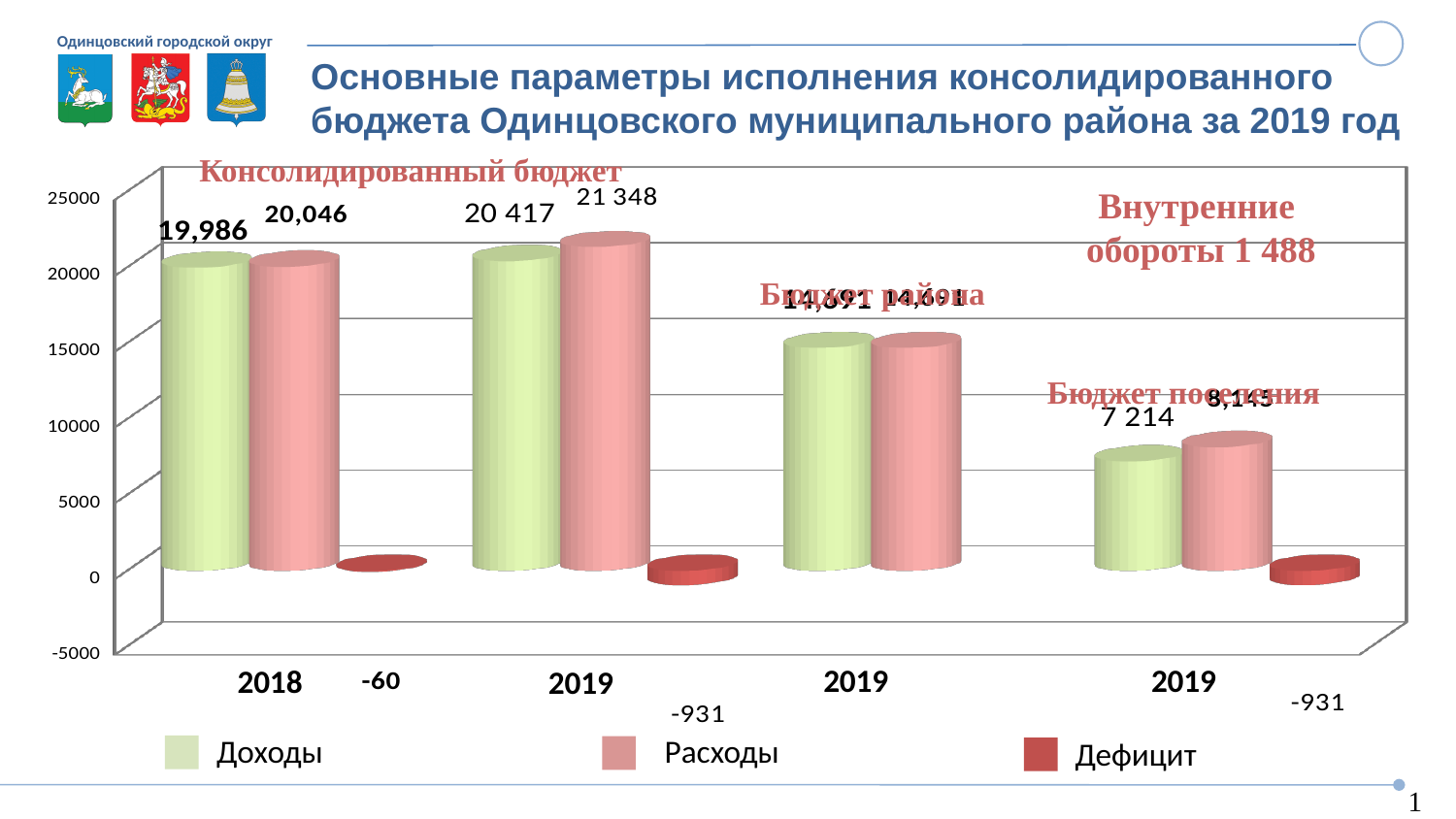
What is the value of Доходы for 2019 in the Консолидированный бюджет group? 20 417 What is the value of Расходы for 2019 in the Консолидированный бюджет group? 21 348 Is the value of Доходы for the Бюджет района group greater or less than 10000? greater How many series does the legend list? 3 What is the value of Расходы for 2018 (Консолидированный бюджет)? 20,046 What kind of chart is shown on the slide? Bar chart What is the value of Доходы for 2018 (Консолидированный бюджет)? 19,986 What is the value of Доходы for the Бюджет поселения group? 7 214 Which is larger for 2018: Доходы or Расходы? Расходы What is the Дефицит value shown for 2018? -60 Which group has the highest Расходы value? 2019 (Консолидированный бюджет) What is the difference between Расходы and Доходы for 2019 in the Консолидированный бюджет group? 931